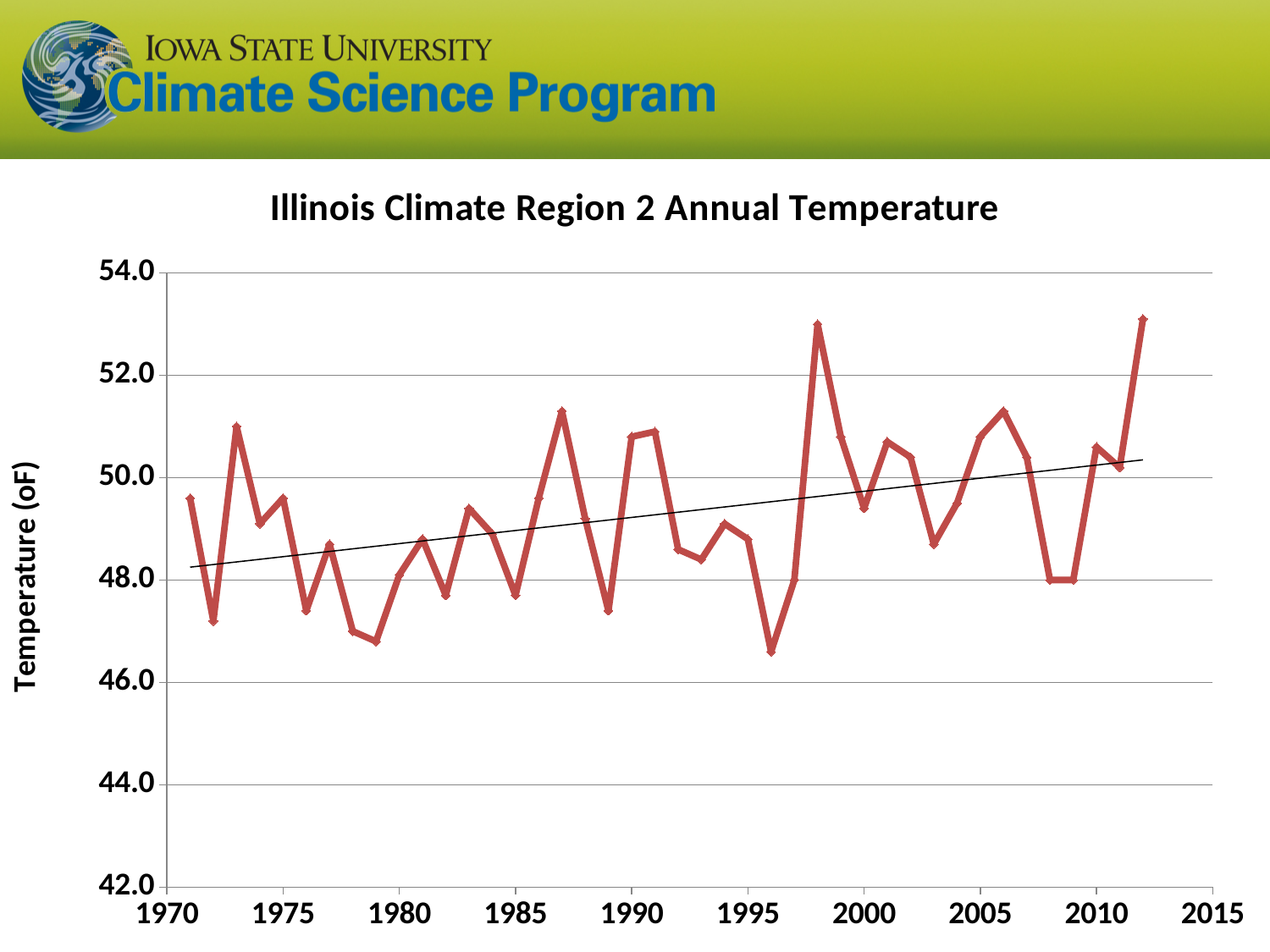
Is the temperature value for 2012 greater or less than 52.0? greater Is the temperature value for 1998 greater or less than 52.0? greater What is the label on the vertical axis of the chart? Temperature (oF) What is the title of the chart? Illinois Climate Region 2 Annual Temperature Is the temperature value for 1979 greater or less than 48.0? less Which year has the higher temperature, 1972 or 1973? 1973 According to the trend line, do annual temperatures rise or fall from 1970 to 2015? rise What kind of chart is shown on the slide? line chart Which year has the higher temperature, 1996 or 1998? 1998